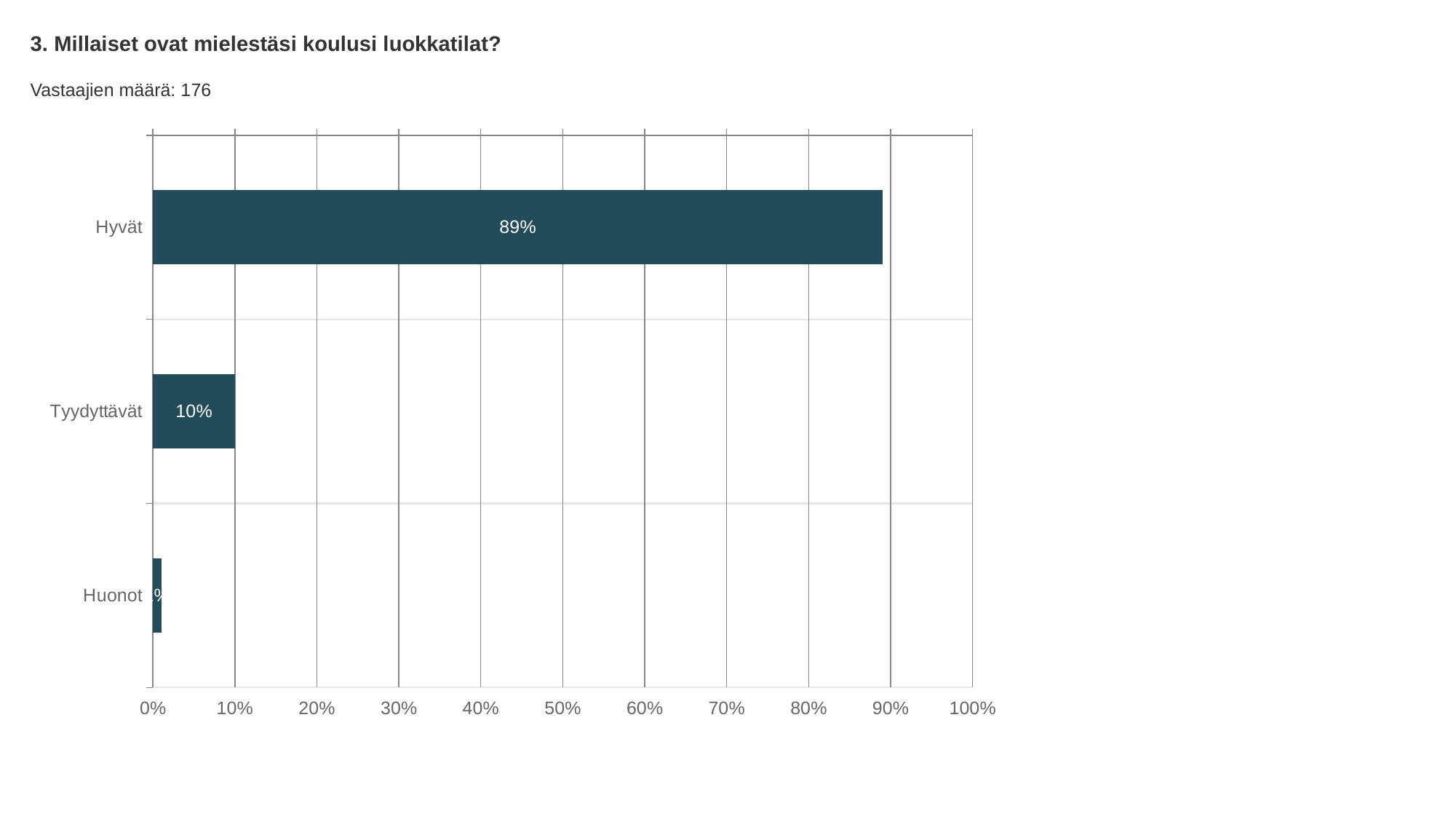
What percentage of respondents answered "Hyvät"? 89% Which is larger, the value for "Tyydyttävät" or the value for "Huonot"? Tyydyttävät Is the value for "Hyvät" greater or less than 80%? greater Is the value for "Huonot" greater or less than 10%? less What is the difference between the values for "Hyvät" and "Tyydyttävät"? 79% Which category has the lowest value? Huonot What is the title of the chart on the slide? 3. Millaiset ovat mielestäsi koulusi luokkatilat? What is the value shown for "Tyydyttävät"? 10% How many categories are shown in the chart? 3 What type of chart is shown on the slide? Bar chart Which category has the highest value? Hyvät How many respondents (Vastaajien määrä) are reported on the slide? 176